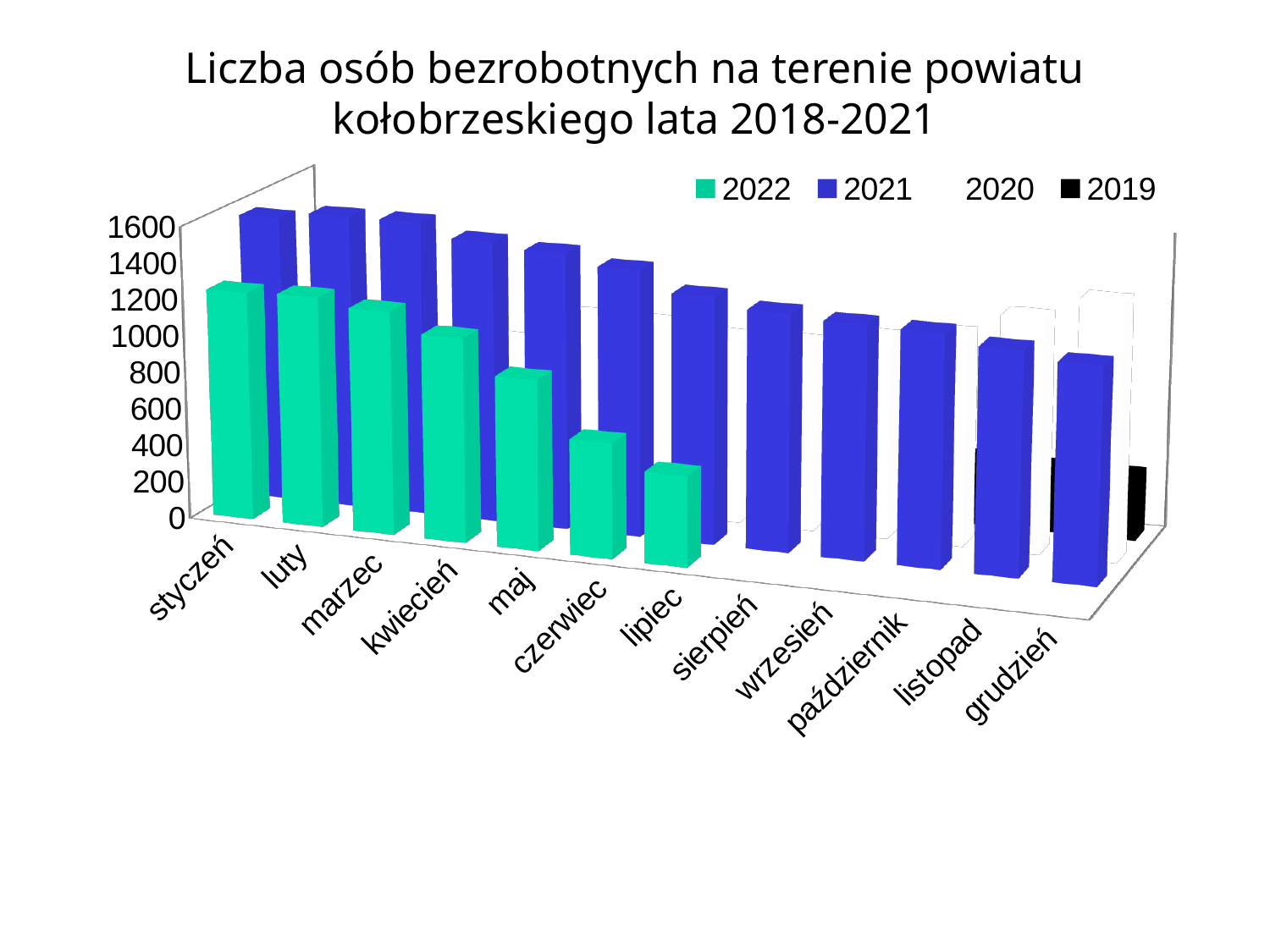
Is the 2022 value for lipiec greater or less than 600? less How many series does the legend list? 4 What kind of chart is shown on the slide? bar chart Which is larger in the 2022 series, styczeń or lipiec? styczeń Which series is drawn in green? 2022 How many month categories are shown on the x axis? 12 What is the title of the chart? Liczba osób bezrobotnych na terenie powiatu kołobrzeskiego lata 2018-2021 For how many months is a 2022 bar plotted? 7 Do the 2022 values rise or fall from styczeń to lipiec? fall Is the 2022 value for styczeń greater or less than 1000? greater Is the 2021 value for styczeń greater or less than 1000? greater Which month has the lowest value in the 2022 series? lipiec